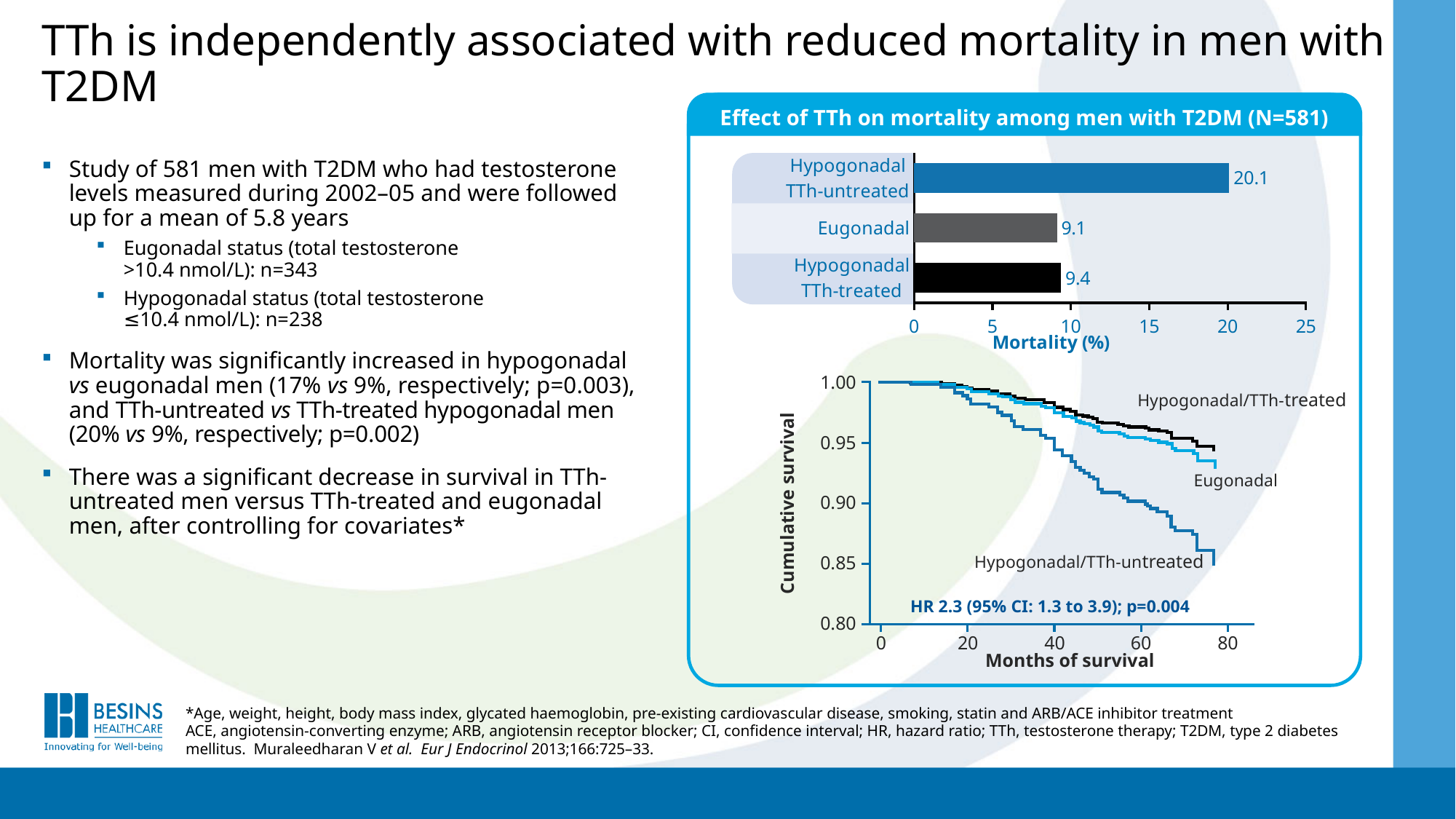
In the bar chart, what is the mortality (%) for the Hypogonadal TTh-untreated group? 20.1 In the bar chart, what is the difference in mortality (%) between the Hypogonadal TTh-untreated and Hypogonadal TTh-treated groups? 10.7 In the bar chart, which group has the lowest mortality? Eugonadal In the bar chart, which group has the highest mortality? Hypogonadal TTh-untreated How many groups are shown in the bar chart? 3 What kind of chart is the upper chart showing mortality (%)? Bar chart In the bar chart, what is the mortality (%) for the Eugonadal group? 9.1 In the bar chart, which group has higher mortality: Eugonadal or Hypogonadal TTh-treated? Hypogonadal TTh-treated In the survival chart, how many curves are plotted? 3 In the bar chart, what is the mortality (%) for the Hypogonadal TTh-treated group? 9.4 In the survival chart, is the cumulative survival for the Hypogonadal/TTh-untreated group at the end of follow-up (around 75 months) greater or less than 0.90? less In the survival chart, what hazard ratio is printed on the plot? HR 2.3 (95% CI: 1.3 to 3.9); p=0.004